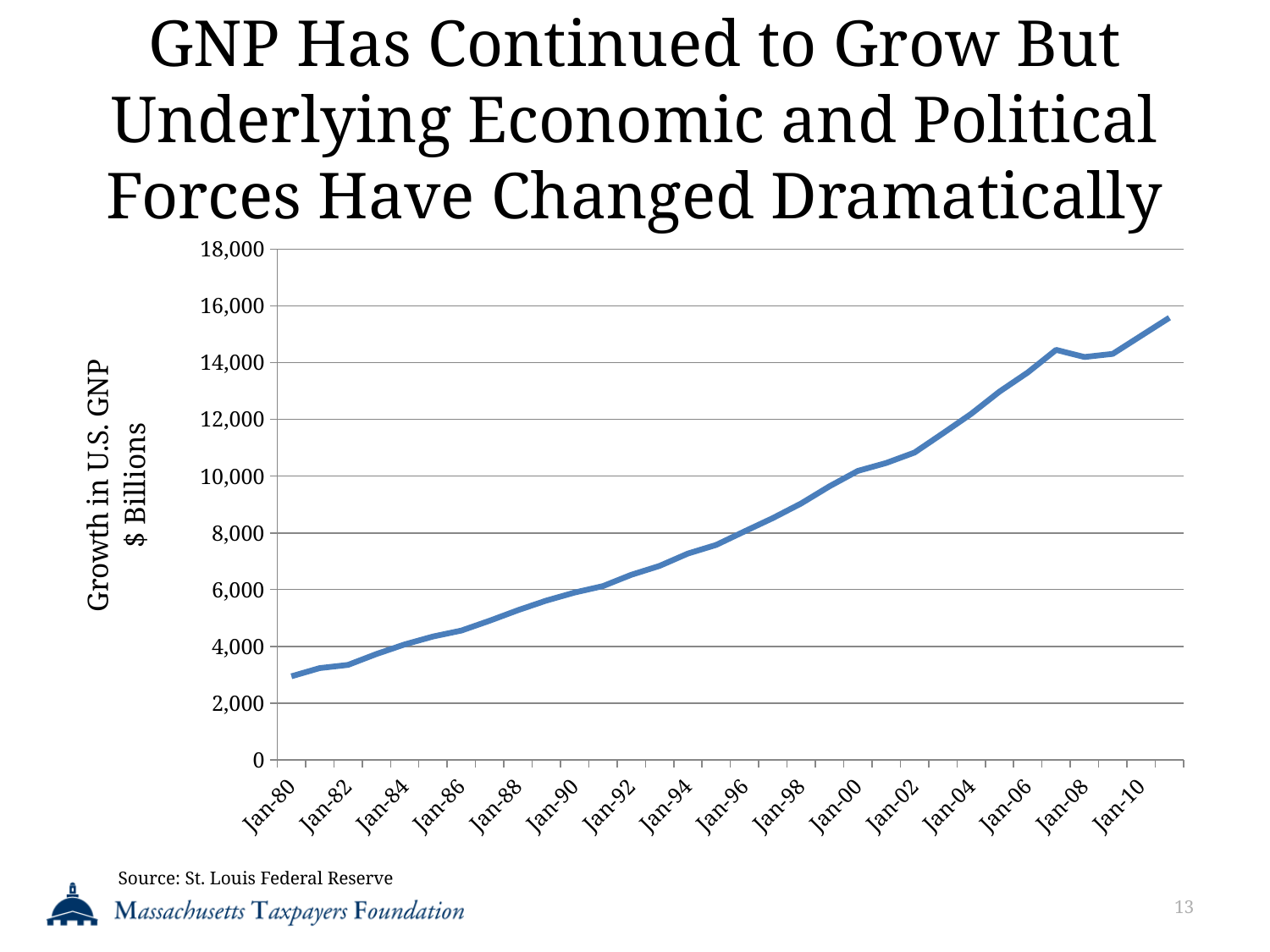
Which has the larger value, Jan-90 or Jan-06? Jan-06 What kind of chart is shown on the slide? line chart At which labelled date is the GNP value lowest? Jan-80 Is the value for Jan-98 greater or less than 8,000? greater Is the value for Jan-86 greater or less than 4,000? greater What is the title of the y axis? Growth in U.S. GNP $ Billions How many date labels are shown on the x axis? 16 Does U.S. GNP generally rise or fall from Jan-80 to Jan-10? rise Is the value for Jan-94 greater or less than 6,000? greater What is the highest value shown on the y axis? 18,000